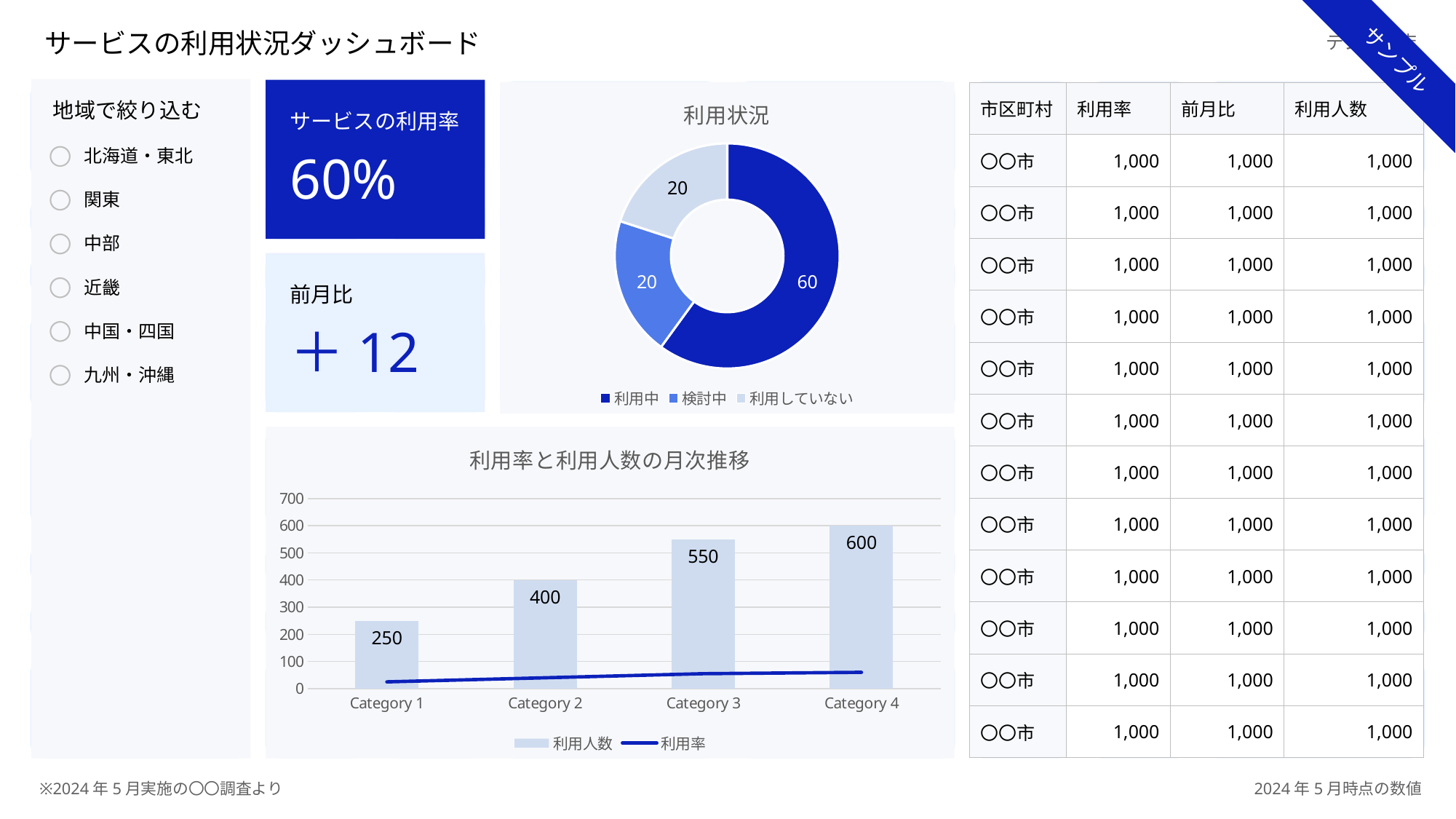
In the 利用状況 chart, how many categories does the legend list? 3 In the 利用状況 chart, which category has the largest value? 利用中 In the 利用率と利用人数の月次推移 chart, how many series does the legend list? 2 In the 利用状況 chart, what share of the total does 利用中 represent? 60% In the 利用率と利用人数の月次推移 chart, what is the 利用人数 value for Category 4? 600 In the 利用状況 chart, what is the value for 利用中? 60 In the 利用率と利用人数の月次推移 chart, what is the difference in 利用人数 between Category 3 and Category 1? 300 In the 利用状況 chart, what is the value for 検討中? 20 In the 利用率と利用人数の月次推移 chart, what is the 利用人数 value for Category 2? 400 In the 利用率と利用人数の月次推移 chart, do the 利用人数 values rise or fall from Category 1 to Category 4? rise In the 利用率と利用人数の月次推移 chart, is the 利用人数 value for Category 3 greater or less than 500? greater In the 利用率と利用人数の月次推移 chart, which category has the lowest 利用人数 value? Category 1